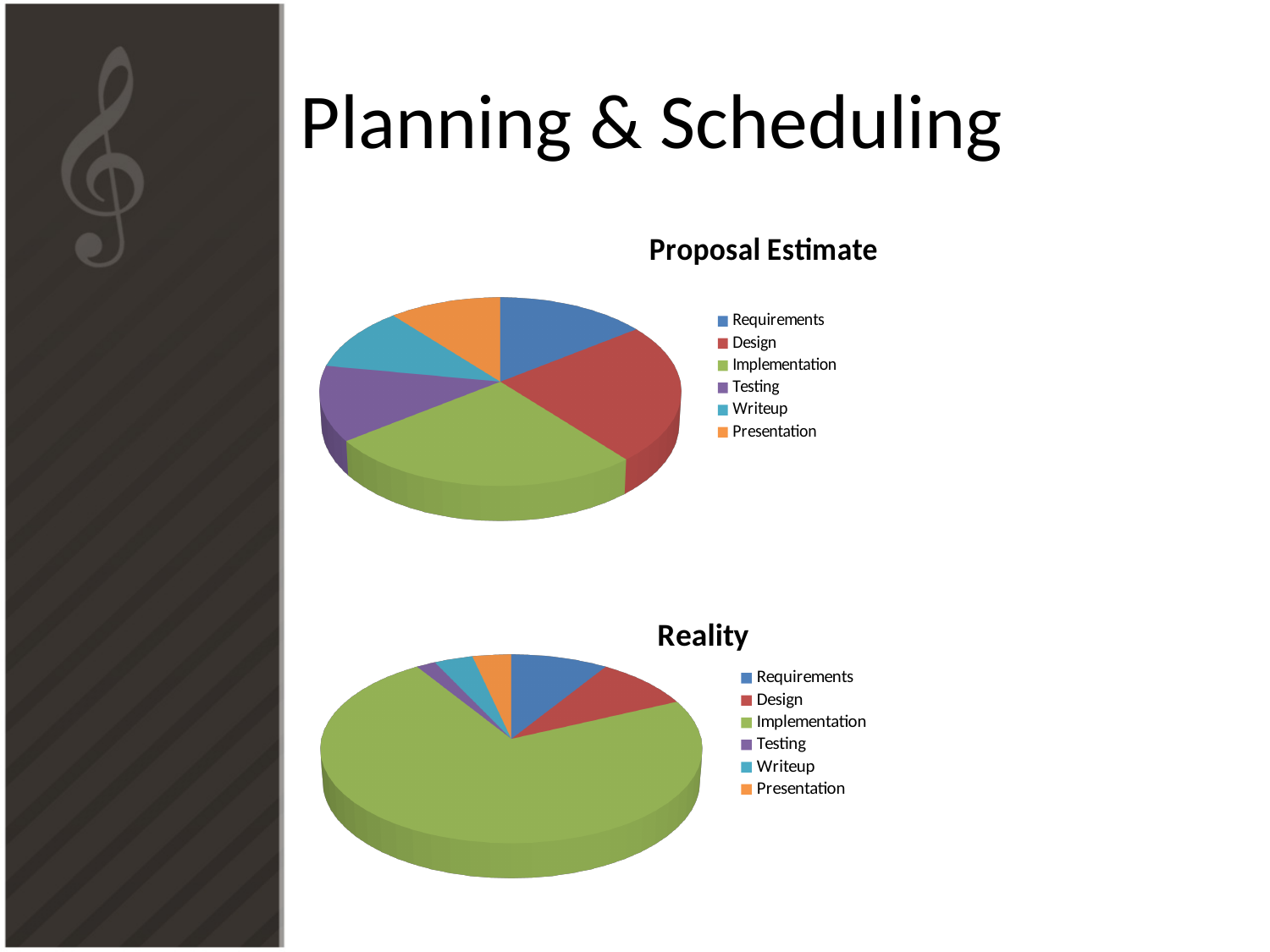
In the Reality chart, which category has the largest slice? Implementation How many categories does the Proposal Estimate pie chart show? 6 In the Proposal Estimate chart, which category has the largest slice? Implementation What kind of chart is the Proposal Estimate chart? pie chart In the Reality chart, what colour is the Implementation slice? green How many categories does the Reality pie chart show? 6 In the Proposal Estimate chart, which slice is larger, Implementation or Design? Implementation What kind of chart is the Reality chart? pie chart In the Reality chart, which slice is larger, Requirements or Testing? Requirements In the Proposal Estimate chart, which slice is larger, Design or Presentation? Design In the Reality chart, which category has the smallest slice? Testing What is the title of the top chart on the slide? Proposal Estimate